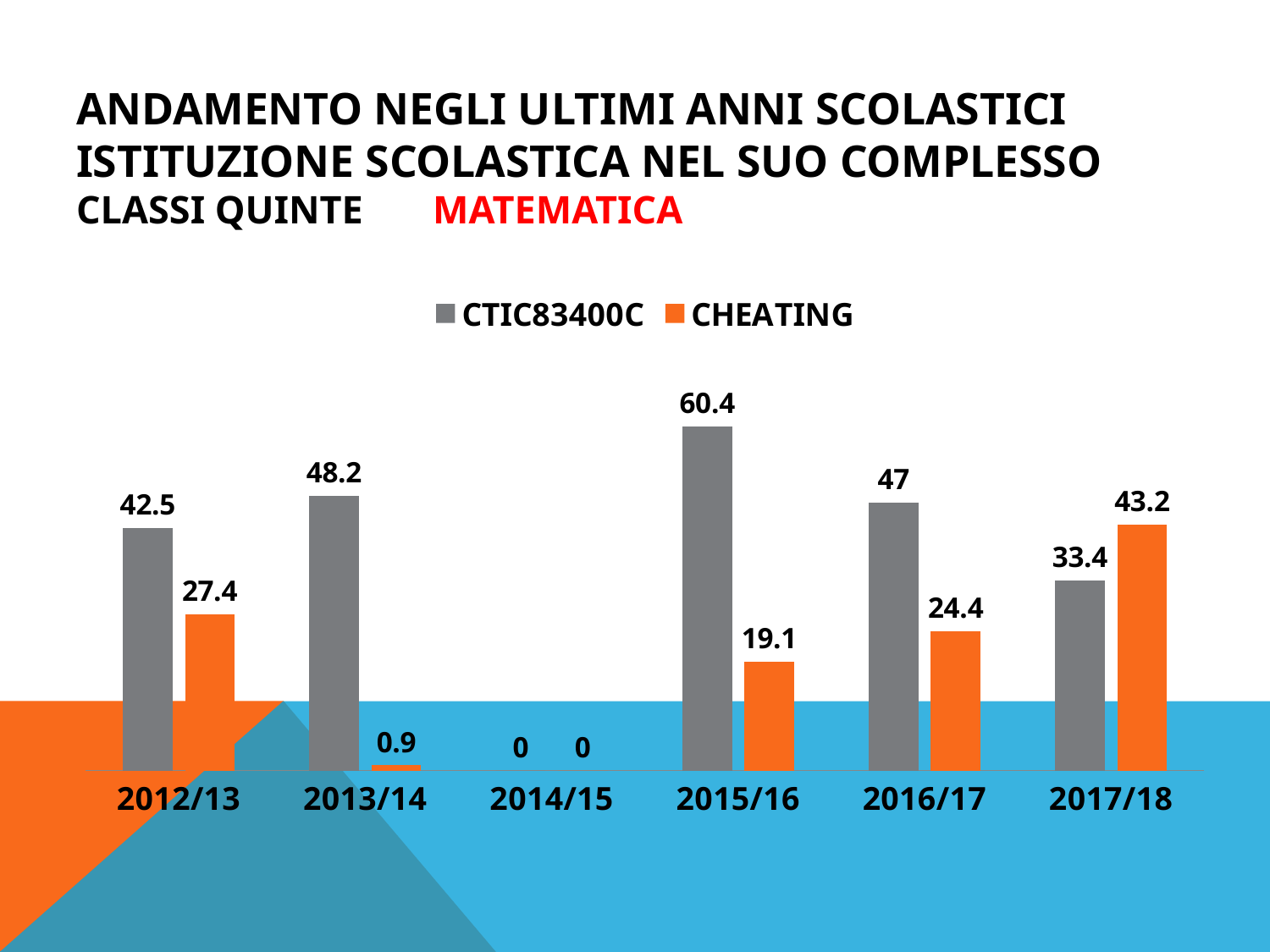
How many school years are shown on the x axis? 6 What is the CTIC83400C value for 2015/16? 60.4 What is the CHEATING value for 2017/18? 43.2 What colour are the CHEATING bars? orange What kind of chart is shown on the slide? bar chart How many series does the legend list? 2 Which school year has the lowest CHEATING value? 2014/15 Does the CHEATING value rise or fall from 2015/16 to 2017/18? rise Which school year has the highest CTIC83400C value? 2015/16 What is the difference between the CTIC83400C and CHEATING values for 2016/17? 22.6 What is the CHEATING value for 2013/14? 0.9 Which is larger for 2017/18, the CTIC83400C value or the CHEATING value? CHEATING